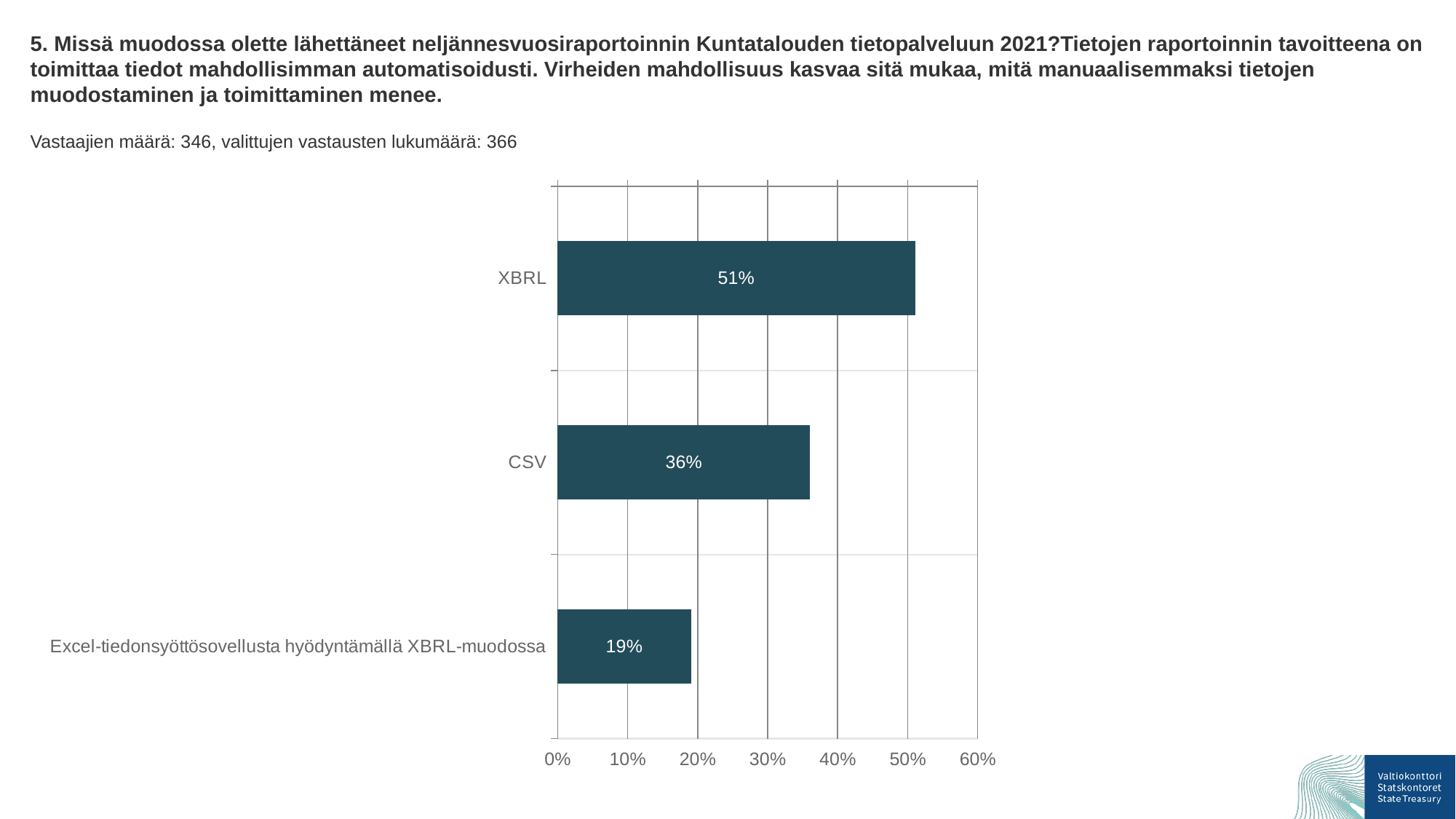
What is the maximum value shown on the horizontal axis? 60% What is the difference between the values for XBRL and CSV? 15% Which category has the highest value? XBRL What is the value for XBRL? 51% What kind of chart is shown on the slide? bar chart Which category has the lowest value? Excel-tiedonsyöttösovellusta hyödyntämällä XBRL-muodossa What is the value for CSV? 36% Which is larger, the value for CSV or the value for Excel-tiedonsyöttösovellusta hyödyntämällä XBRL-muodossa? CSV How many categories are shown in the chart? 3 What is the value for Excel-tiedonsyöttösovellusta hyödyntämällä XBRL-muodossa? 19% What is the difference between the values for CSV and Excel-tiedonsyöttösovellusta hyödyntämällä XBRL-muodossa? 17% Is the value for XBRL greater or less than 50%? greater